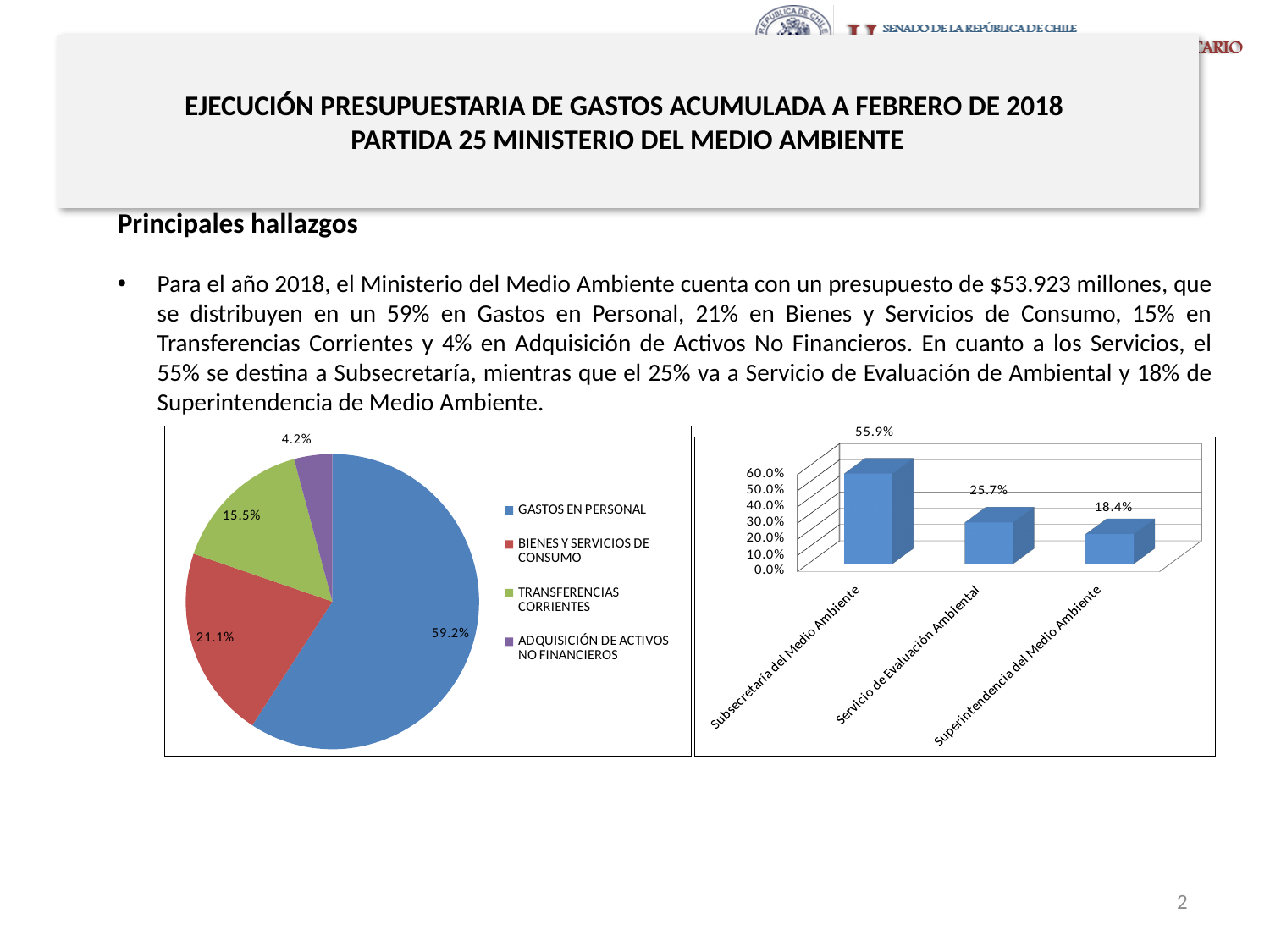
In the bar chart on the right, which category has the highest value? Subsecretaría del Medio Ambiente In the pie chart on the left, which category has the largest slice? GASTOS EN PERSONAL In the bar chart on the right, do the values rise or fall from left to right? Fall In the pie chart on the left, what is the difference between BIENES Y SERVICIOS DE CONSUMO and TRANSFERENCIAS CORRIENTES? 5.6% In the bar chart on the right, what is the difference between Subsecretaría del Medio Ambiente and Superintendencia del Medio Ambiente? 37.5% What kind of chart is shown on the right side of the slide? Bar chart In the pie chart on the left, what is the value for TRANSFERENCIAS CORRIENTES? 15.5% In the pie chart on the left, how many categories does the legend list? 4 In the pie chart on the left, which category has the smallest slice? ADQUISICIÓN DE ACTIVOS NO FINANCIEROS In the pie chart on the left, what colour is the GASTOS EN PERSONAL slice? Blue In the pie chart on the left, what share does GASTOS EN PERSONAL have? 59.2% In the bar chart on the right, what is the value for Servicio de Evaluación Ambiental? 25.7%